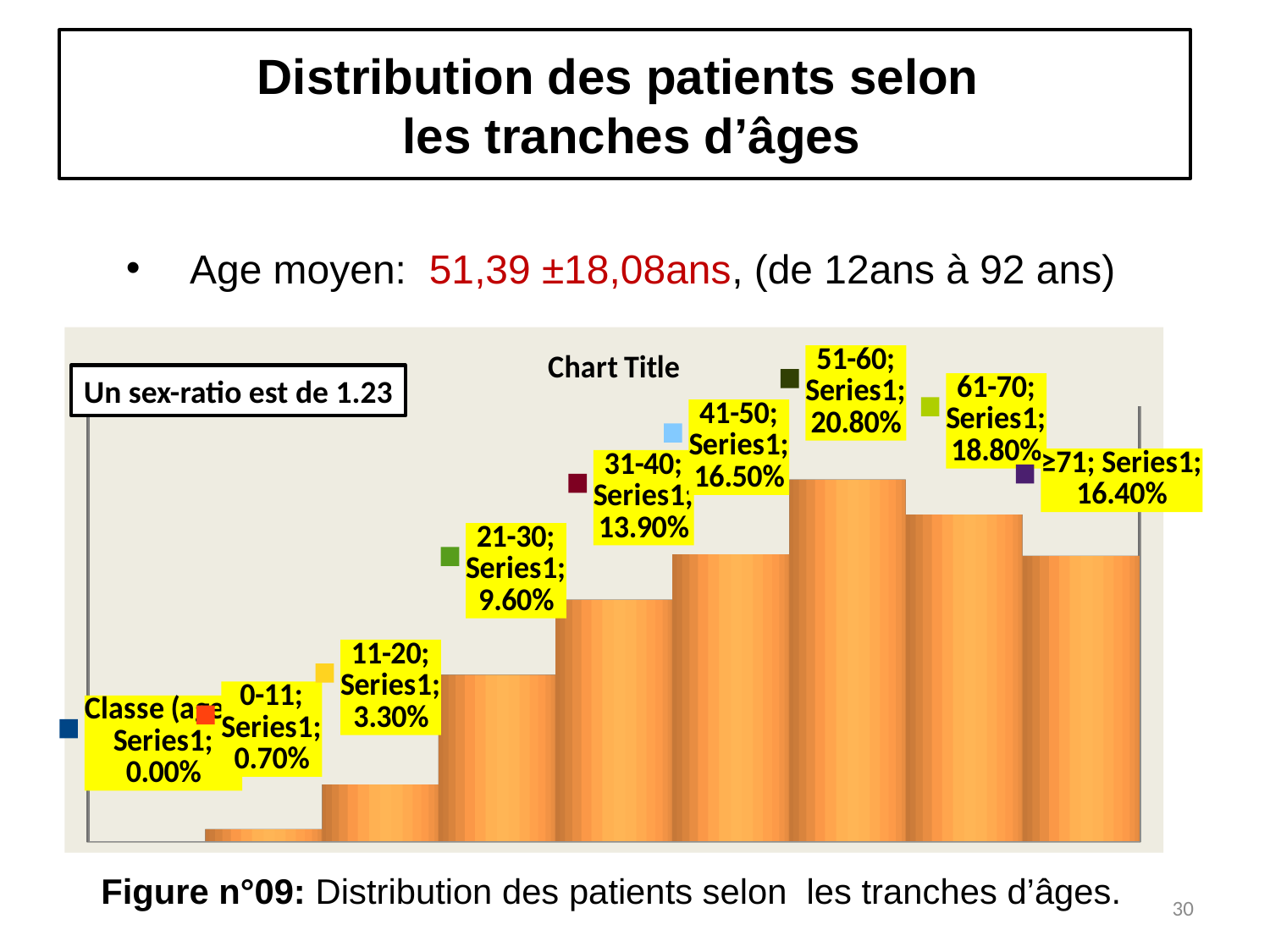
What kind of chart is shown on the slide? Bar chart Which is larger, the value for 61-70 or the value for ≥71? 61-70 What is the value for the 11-20 age group? 3.30% What is the difference between the values for 51-60 and 61-70? 2.00% What is the value for the 21-30 age group? 9.60% What is the difference between the values for 41-50 and 31-40? 2.60% Which age group has the lowest non-zero value? 0-11 What is the value for the 51-60 age group? 20.80% Do the values rise or fall from the 0-11 group to the 51-60 group? Rise What is the title printed on the chart? Chart Title Which age group has the highest value? 51-60 What is the value for the ≥71 age group? 16.40%